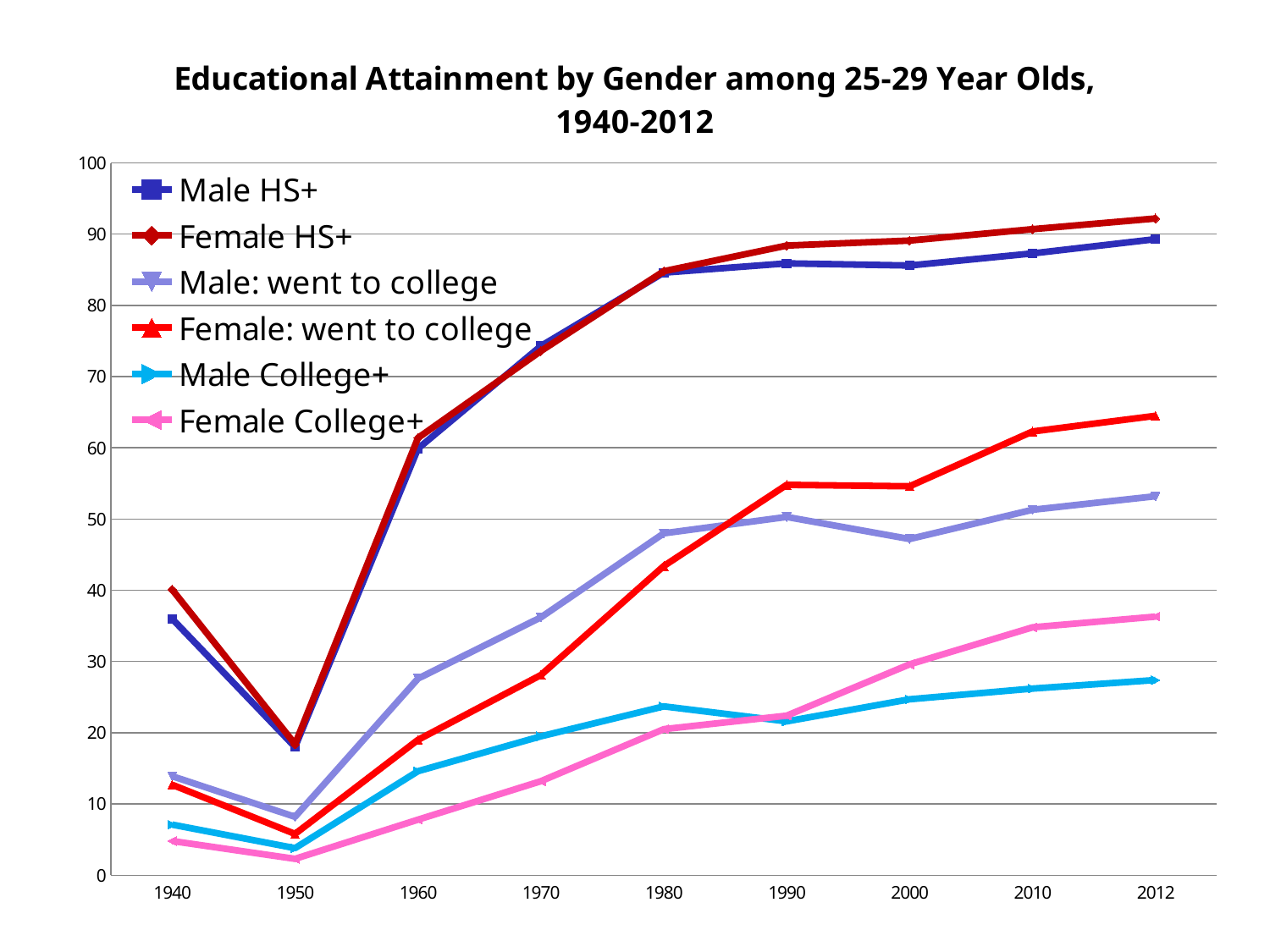
Is the value for Female College+ in 2012 greater or less than 30? greater What kind of chart is shown on the slide? line chart Is the value for Male: went to college in 2000 greater or less than 50? less Is the value for Female HS+ in 2012 greater or less than 90? greater How many series does the legend list? 6 What is the title of the chart? Educational Attainment by Gender among 25-29 Year Olds, 1940-2012 How many years are marked along the x axis? 9 In 2012, which is higher: Female: went to college or Male: went to college? Female: went to college In 1940, which is higher: Male HS+ or Female HS+? Female HS+ In which year is the Male HS+ value lowest? 1950 Which series has the highest value in 2012? Female HS+